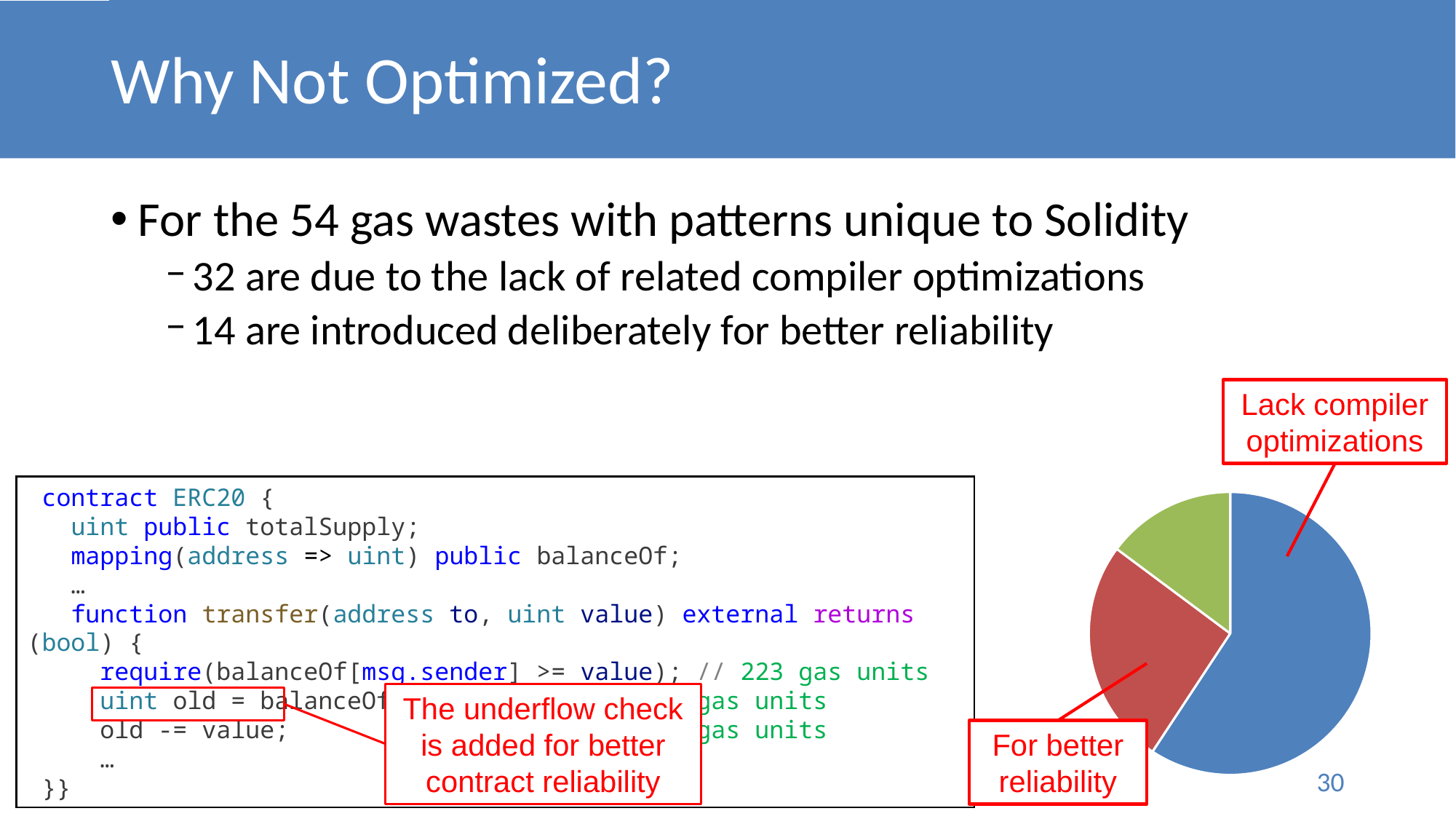
According to the slide text, how many of the 54 gas wastes are introduced deliberately for better reliability? 14 Which category has the largest slice in the pie chart? Lack compiler optimizations Is the Lack compiler optimizations slice more or less than half of the pie? more Which of the two labelled categories has the smaller slice? For better reliability What colour is the slice labelled For better reliability? red What colour is the slice labelled Lack compiler optimizations? blue According to the slide text, how many of the 54 gas wastes are due to the lack of related compiler optimizations? 32 How many slices of the pie chart are labelled with a callout? 2 How many slices does the pie chart have? 3 Which of the two labelled slices, Lack compiler optimizations or For better reliability, is larger? Lack compiler optimizations What kind of chart is shown on the slide? pie chart Is the For better reliability slice more or less than half of the pie? less